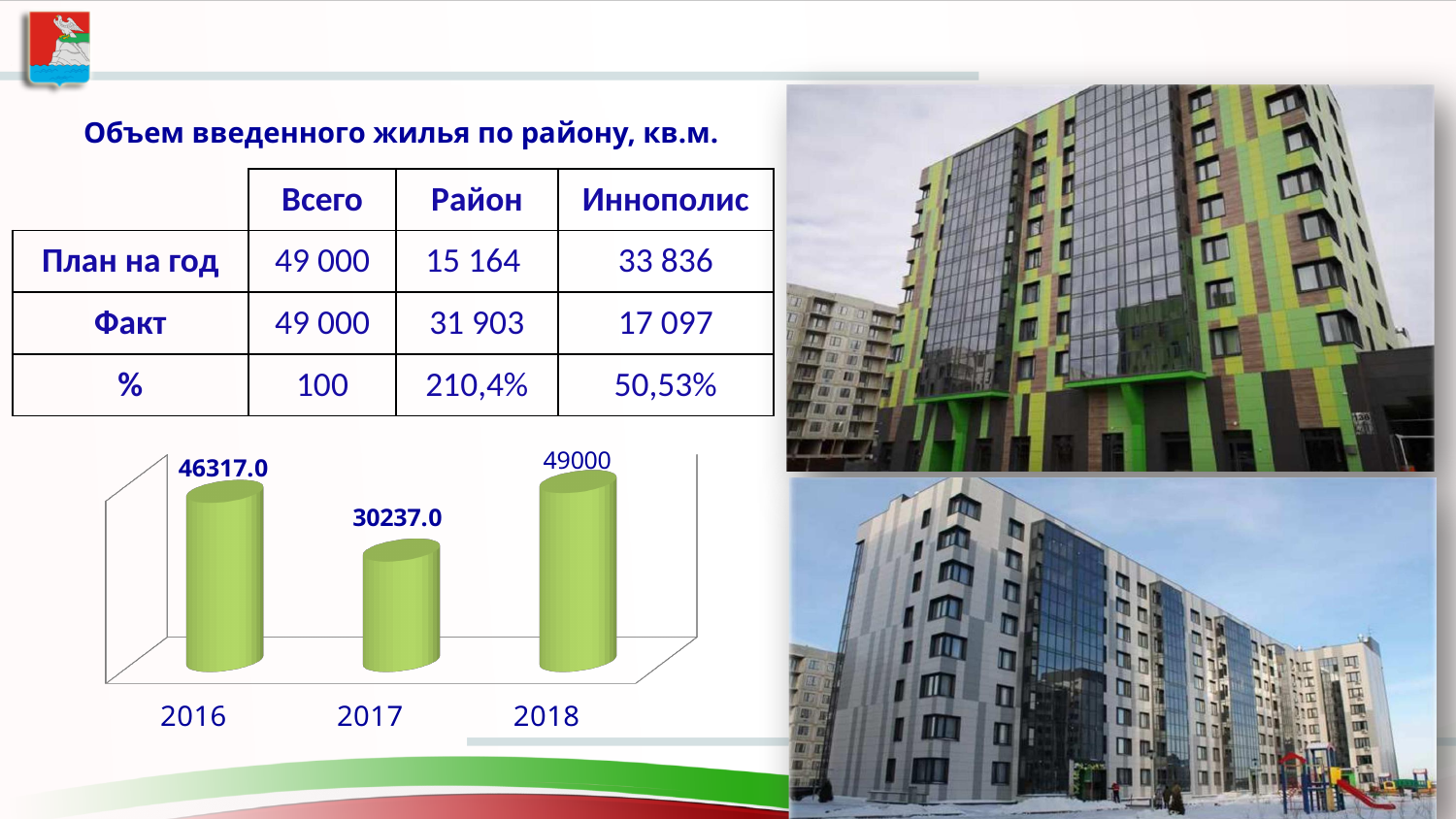
Which year has the lowest value in the bar chart? 2017 What is the value shown for 2016 in the bar chart? 46317.0 How many years are shown in the bar chart? 3 Which year has the highest value in the bar chart? 2018 Does the value rise or fall from 2017 to 2018 in the bar chart? rise What colour are the bars in the bar chart? green What is the difference between the values for 2018 and 2016 in the bar chart? 2683.0 What kind of chart is shown on the slide? bar chart Which is larger in the bar chart, the value for 2016 or the value for 2017? 2016 What is the value shown for 2018 in the bar chart? 49000 What is the value shown for 2017 in the bar chart? 30237.0 What is the difference between the values for 2016 and 2017 in the bar chart? 16080.0